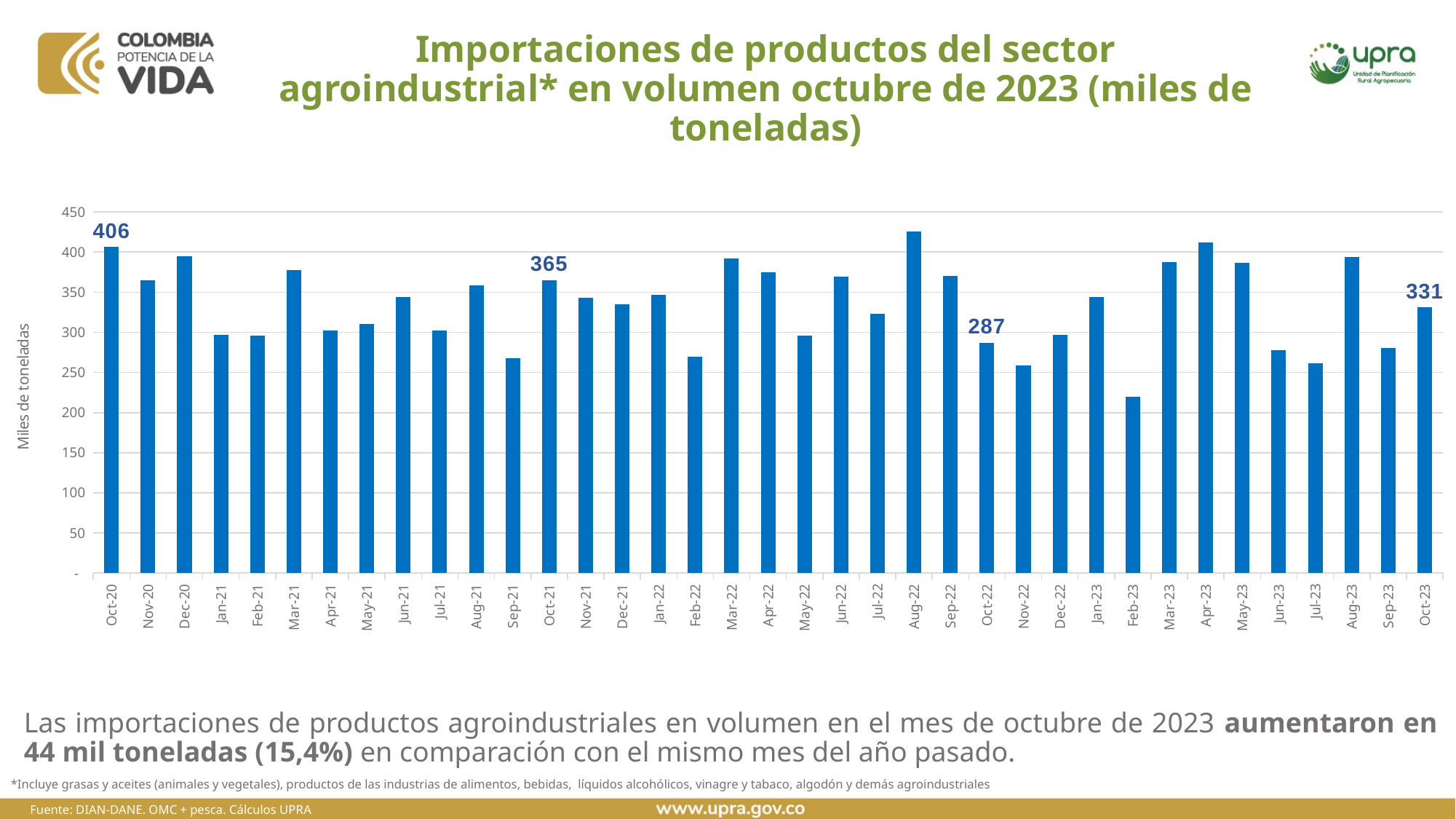
What is the value for Oct-23? 331 How many months are plotted on the chart? 37 What is the value for Oct-21? 365 What is the value for Oct-20? 406 What is the difference between the values for Oct-23 and Oct-22? 44 What is the value for Oct-22? 287 Which month has the highest bar? Aug-22 What kind of chart is shown on the slide? bar chart Is the value for Feb-23 greater or less than 250? less Is the value for Aug-22 greater or less than 400? greater Which is larger, the value for Oct-20 or the value for Oct-21? Oct-20 Which month has the lowest bar? Feb-23